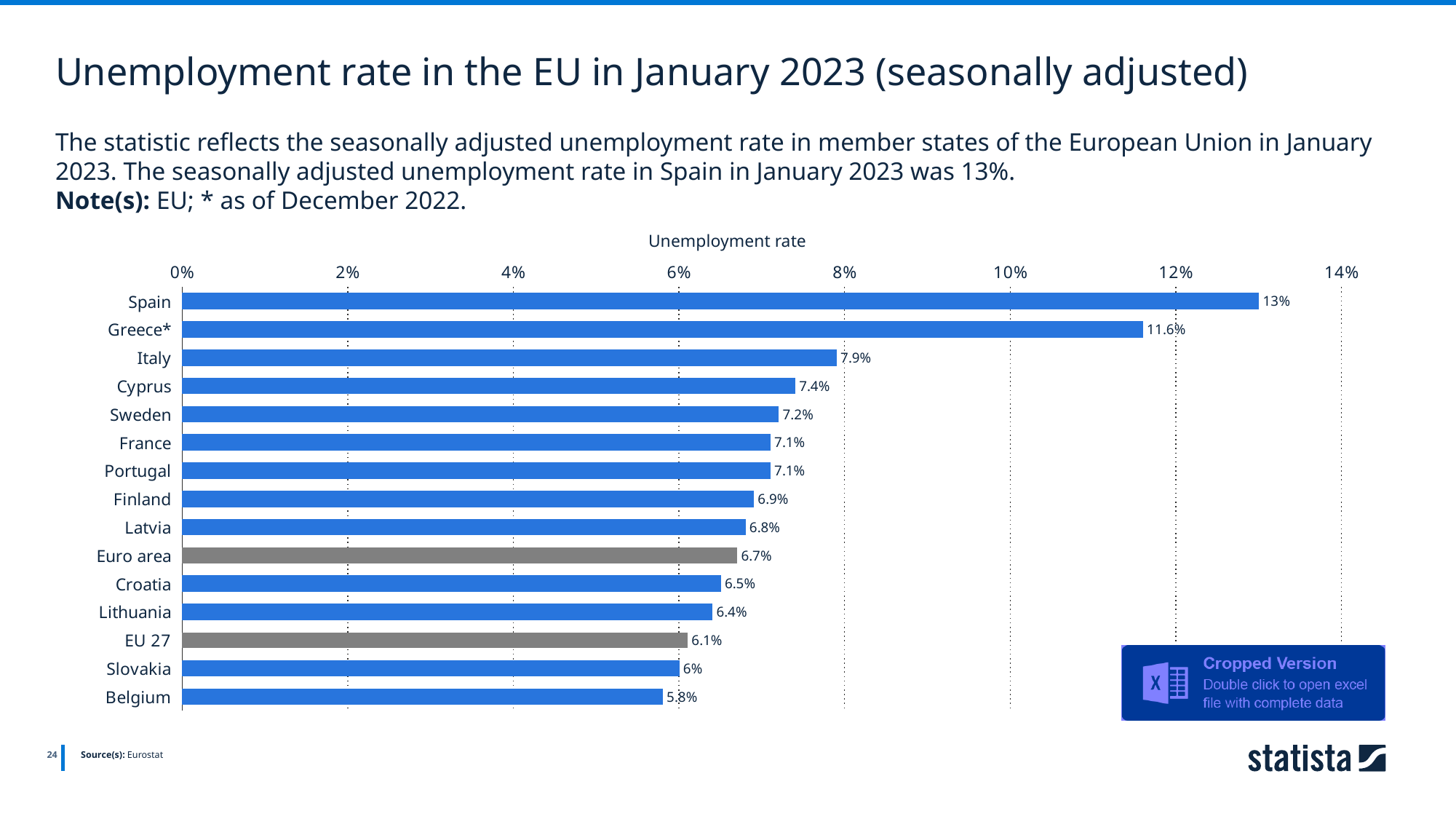
Is the value for Sweden greater or less than 8%? less What kind of chart is shown on the slide? Bar chart What is the unemployment rate for EU 27? 6.1% What is the difference between the unemployment rates of Spain and Greece*? 1.4% What is the unemployment rate for the Euro area? 6.7% What is the unemployment rate for Greece*? 11.6% Which two bars are coloured grey instead of blue? Euro area and EU 27 Which category has the lowest unemployment rate on the chart? Belgium Which country has the highest unemployment rate on the chart? Spain Which has a higher unemployment rate, Italy or Cyprus? Italy What is the unemployment rate for Spain? 13% How many categories are shown on the chart? 15